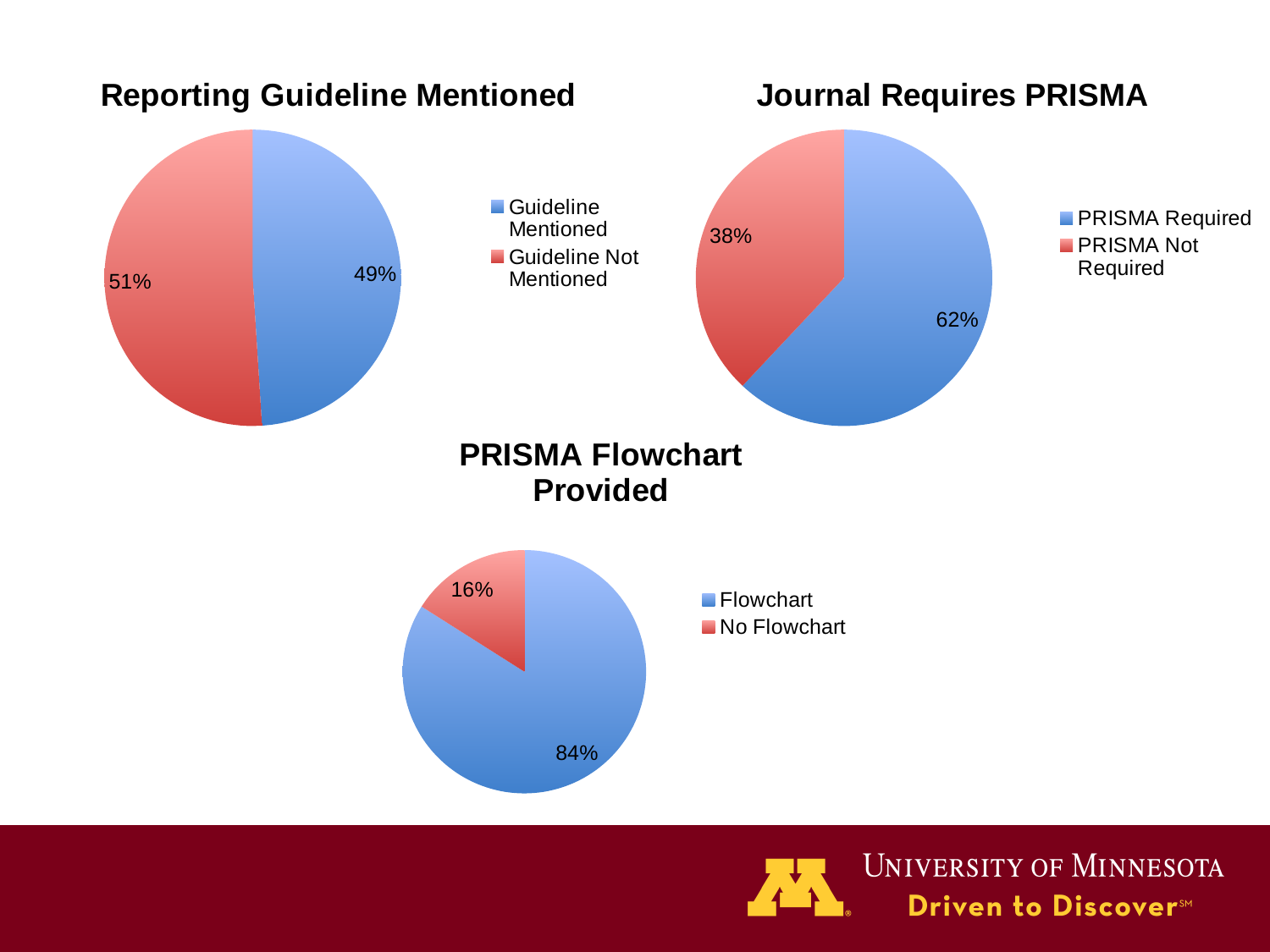
In the 'Journal Requires PRISMA' chart, what is the difference between 'PRISMA Required' and 'PRISMA Not Required'? 24% In the 'PRISMA Flowchart Provided' chart, what share of the pie is 'No Flowchart'? 16% In the 'Reporting Guideline Mentioned' chart, which is larger, 'Guideline Mentioned' or 'Guideline Not Mentioned'? Guideline Not Mentioned In the 'Journal Requires PRISMA' chart, what is the value for 'PRISMA Not Required'? 38% How many categories does the legend of the 'Journal Requires PRISMA' chart list? 2 In the 'PRISMA Flowchart Provided' chart, which category is the largest? Flowchart In the 'Journal Requires PRISMA' chart, which category is the smallest? PRISMA Not Required In the 'Reporting Guideline Mentioned' chart, what share of the pie is 'Guideline Not Mentioned'? 51% In the 'Reporting Guideline Mentioned' chart, what share of the pie is 'Guideline Mentioned'? 49% What kind of chart is the 'PRISMA Flowchart Provided' chart? Pie chart In the 'PRISMA Flowchart Provided' chart, what is the difference between 'Flowchart' and 'No Flowchart'? 68% In the 'Journal Requires PRISMA' chart, what is the value for 'PRISMA Required'? 62%